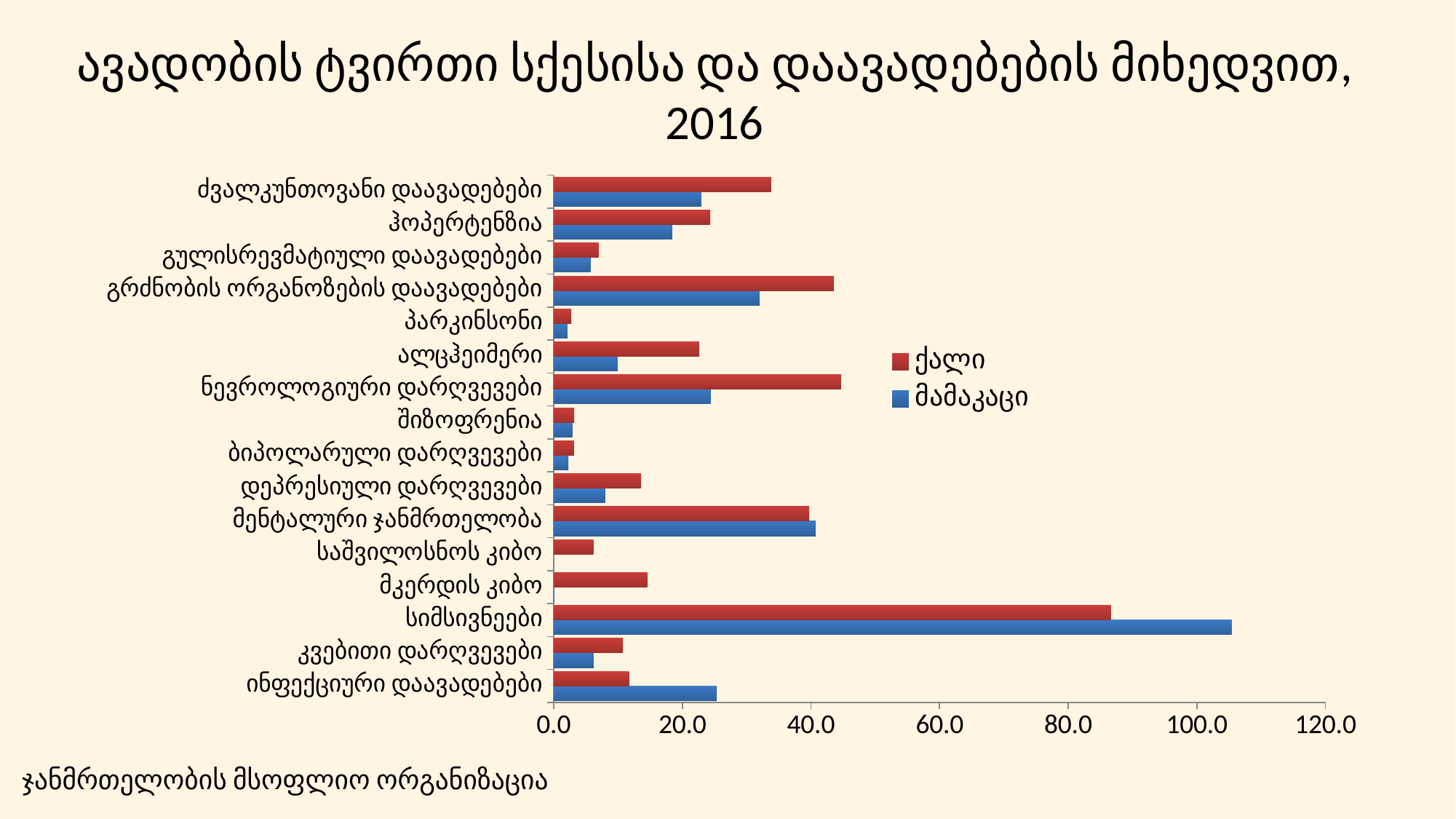
Is the მამაკაცი value for ალცჰეიმერი greater or less than 20? less For ალცჰეიმერი, which series has the larger value, ქალი or მამაკაცი? ქალი Is the მამაკაცი value for სიმსივნეები greater or less than 100? greater Which colour represents the ქალი series in the chart? red For ინფექციური დაავადებები, which series has the larger value, ქალი or მამაკაცი? მამაკაცი Which category has the highest value for the ქალი series? სიმსივნეები Is the ქალი value for ნევროლოგიური დარღვევები greater or less than 40? greater How many series does the legend list? 2 Which category has the highest value for the მამაკაცი series? სიმსივნეები What kind of chart is shown on the slide? bar chart How many categories are shown on the vertical axis of the chart? 16